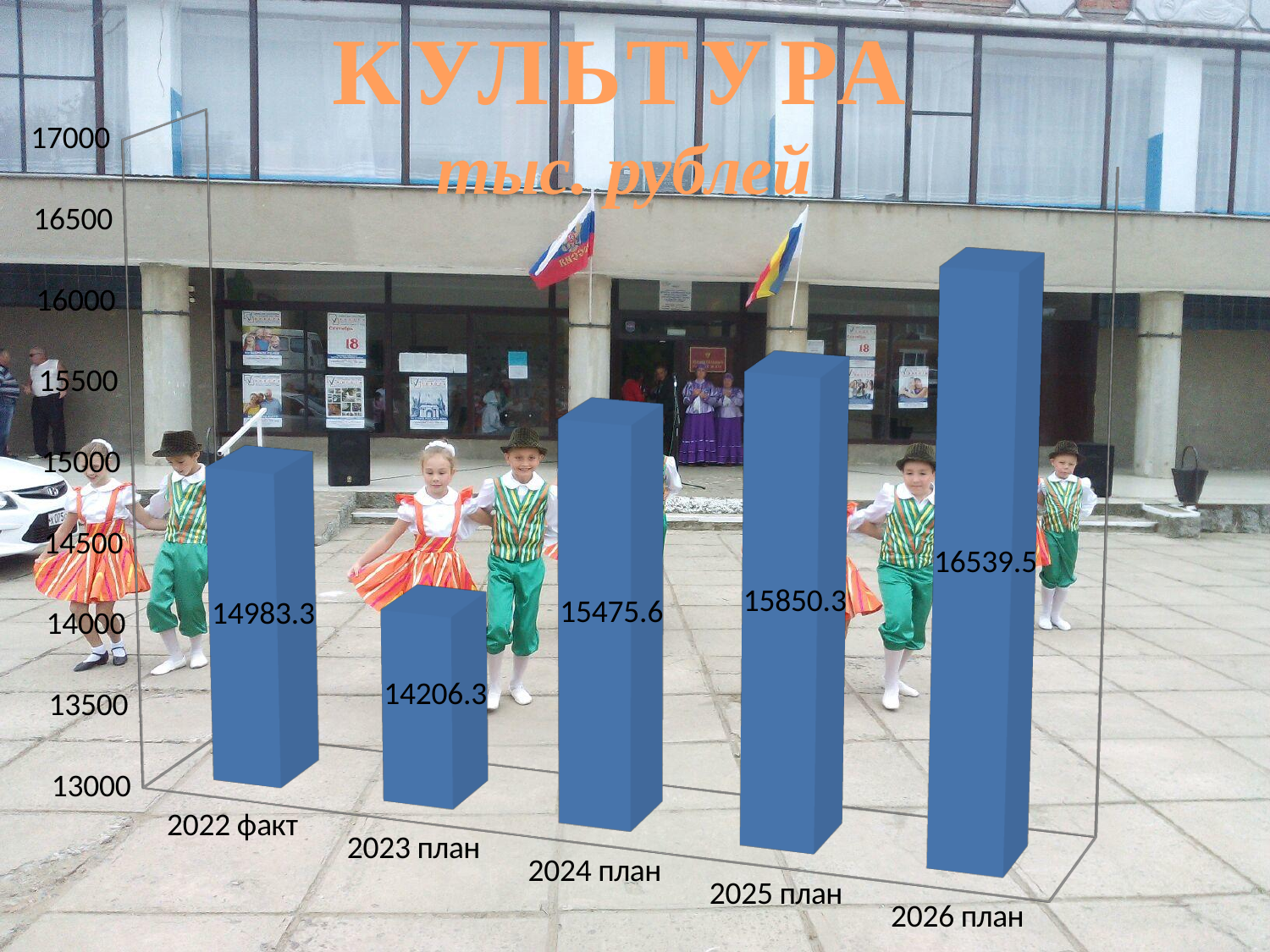
What is the value for 2024 план? 15475.6 Which category has the highest value? 2026 план Which category has the lowest value? 2023 план How many categories are shown on the x axis? 5 Is the value for 2025 план greater or less than 15500? greater What unit is given in the chart's subtitle? тыс. рублей What kind of chart is shown on the slide? bar chart What is the value for 2022 факт? 14983.3 Which is larger, the value for 2022 факт or the value for 2023 план? 2022 факт What is the value for 2026 план? 16539.5 What is the difference between the values for 2026 план and 2023 план? 2333.2 What is the difference between the values for 2025 план and 2024 план? 374.7